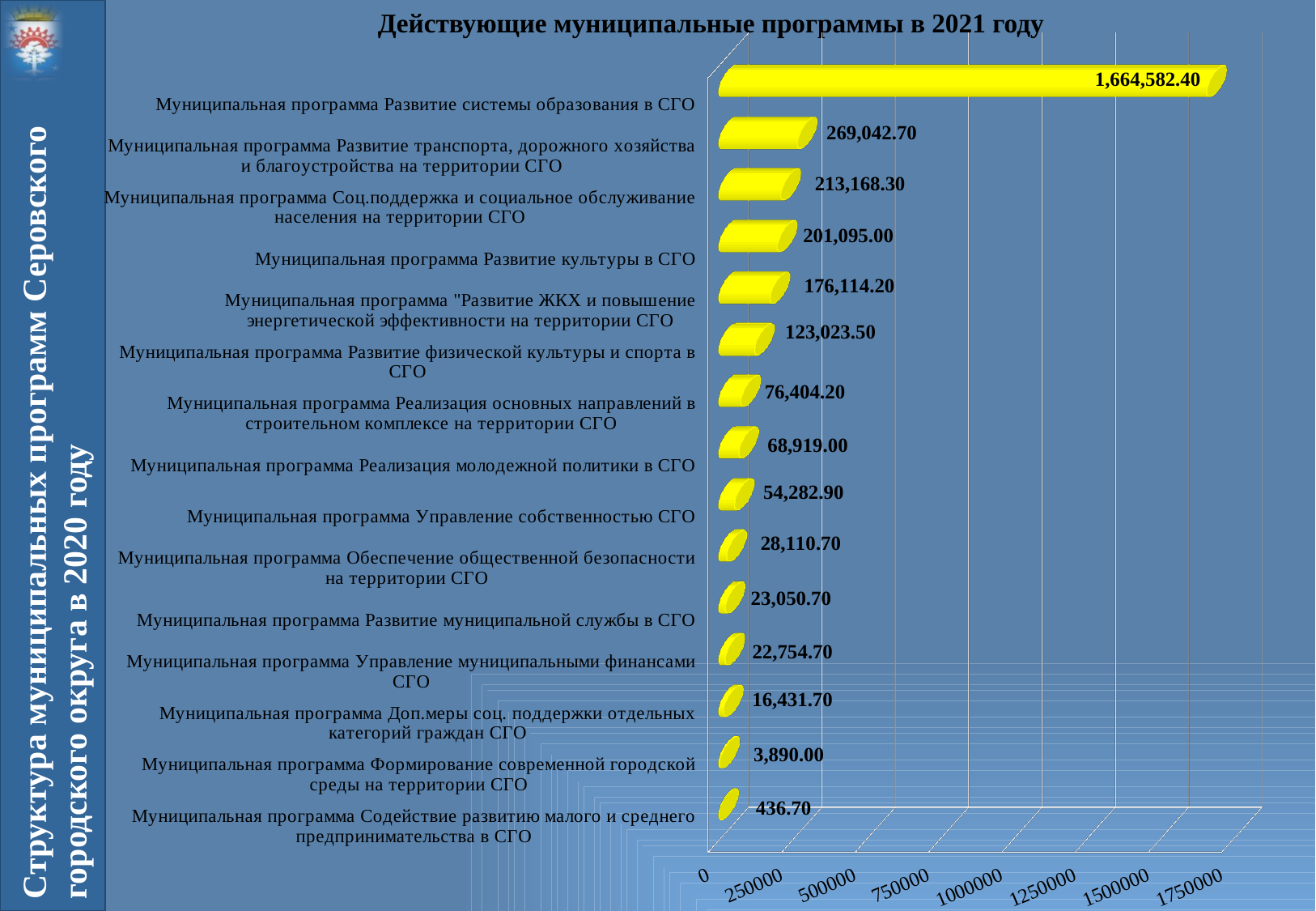
Which program has the highest value? Муниципальная программа Развитие системы образования в СГО Is the value for 'Развитие системы образования в СГО' greater or less than 1500000? greater What is the difference between the values for 'Развитие транспорта, дорожного хозяйства и благоустройства на территории СГО' and 'Соц.поддержка и социальное обслуживание населения на территории СГО'? 55,874.40 How many municipal programs are shown in the chart? 15 What is the value for the program 'Развитие культуры в СГО'? 201,095.00 What type of chart is shown on the slide? bar chart Which is larger: the value for 'Развитие физической культуры и спорта в СГО' or for 'Реализация основных направлений в строительном комплексе на территории СГО'? Развитие физической культуры и спорта в СГО What is the value for the program 'Реализация молодежной политики в СГО'? 68,919.00 What is the value for the program 'Развитие системы образования в СГО'? 1,664,582.40 What is the difference between the values for 'Развитие муниципальной службы в СГО' and 'Управление муниципальными финансами СГО'? 296.00 What is the value for the program 'Формирование современной городской среды на территории СГО'? 3,890.00 Which program has the lowest value? Муниципальная программа Содействие развитию малого и среднего предпринимательства в СГО